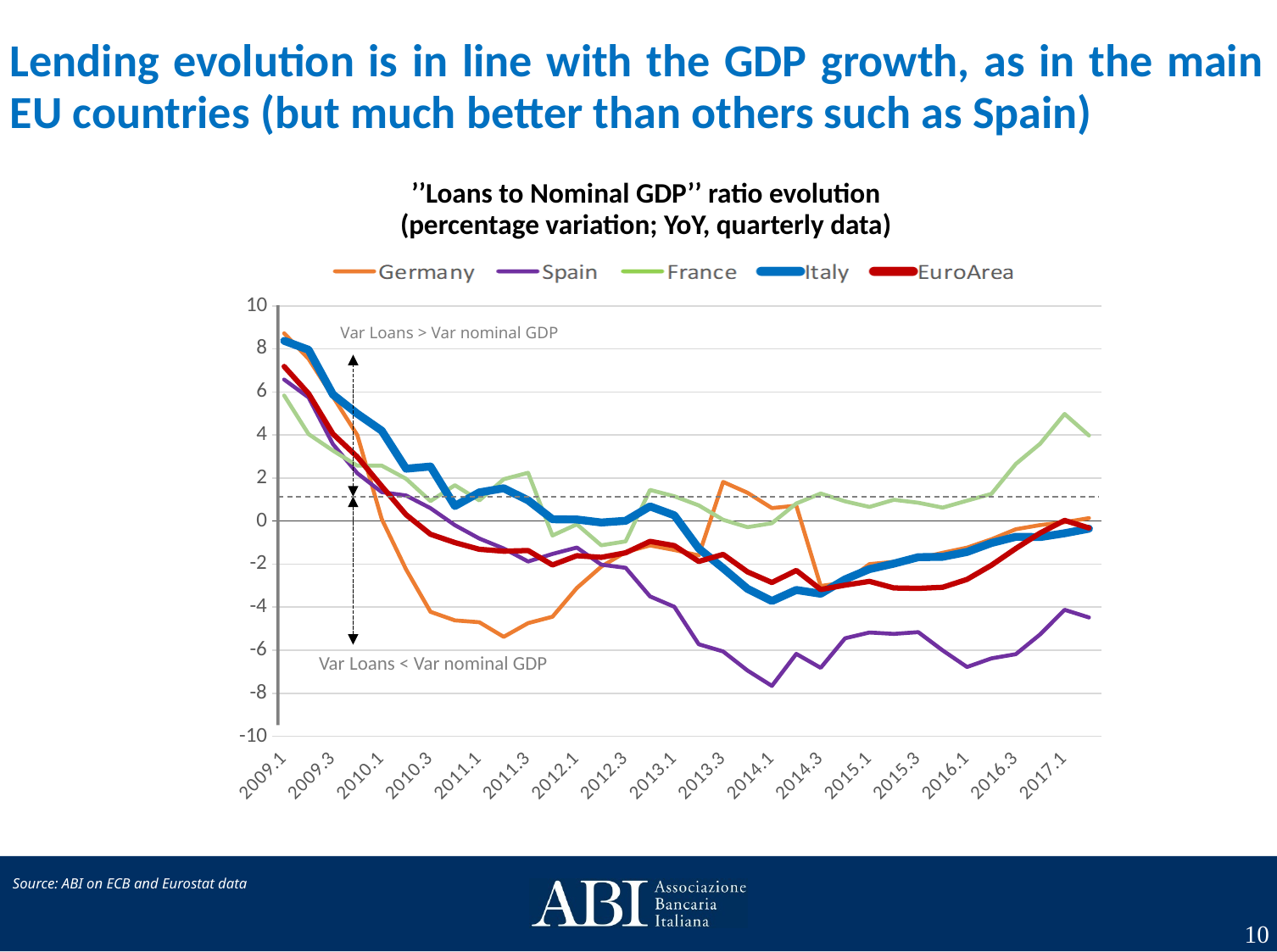
Is the value for Spain at 2014.1 greater or less than -6? less How many series does the legend list? 5 Is the value for Germany at 2011.1 greater or less than -4? less Is the value for Italy at 2009.1 greater or less than 6? greater Does the Italy series rise or fall between 2009.1 and 2014.1? fall Which series has the lowest value at 2014.1? Spain At 2015.3, which is larger, the value for France or the value for Spain? France Which series has the highest value at 2017.1? France Which series are listed in the chart legend? Germany, Spain, France, Italy, EuroArea What kind of chart is shown on the slide? line chart What is the title of the chart? ''Loans to Nominal GDP'' ratio evolution (percentage variation; YoY, quarterly data)